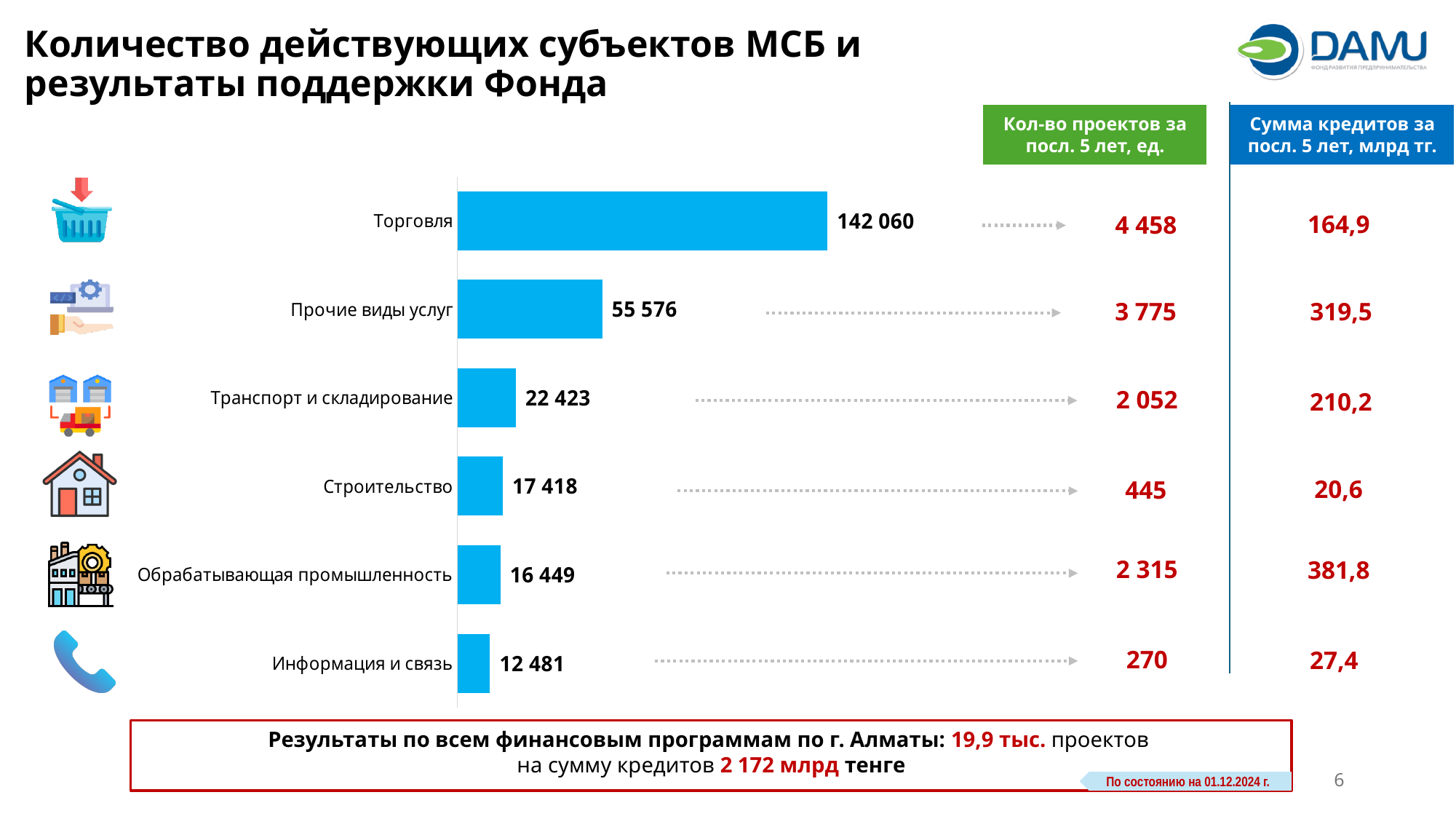
What colour are the bars in the chart? Blue What is the value shown for Торговля? 142 060 Which category has the lowest value in the bar chart? Информация и связь What is the value shown for Транспорт и складирование? 22 423 What is the difference between the values for Торговля and Прочие виды услуг? 86 484 How many categories are shown in the bar chart? 6 What is the value shown for Информация и связь? 12 481 What is the value shown for Прочие виды услуг? 55 576 Which is larger: the value for Строительство or the value for Обрабатывающая промышленность? Строительство Which category has the highest value in the bar chart? Торговля What is the difference between the values for Транспорт и складирование and Строительство? 5 005 What type of chart is shown on the slide? Bar chart